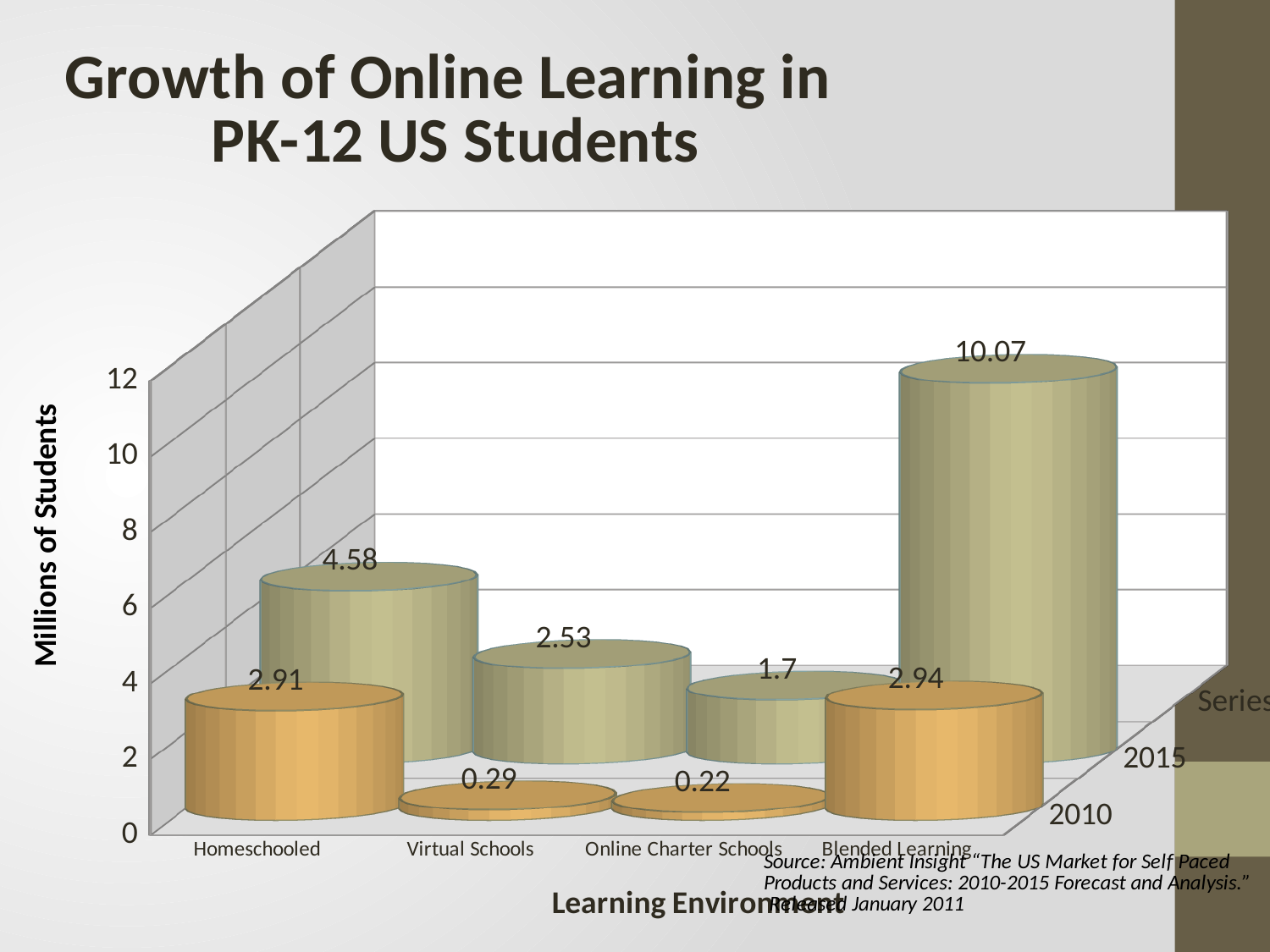
What is the value for Blended Learning in 2015? 10.07 What is the value for Homeschooled in 2010? 2.91 Which learning environment has the highest value in 2015? Blended Learning How many learning environment categories are shown on the x axis? 4 What is the value for Online Charter Schools in 2010? 0.22 What type of chart is shown on the slide? Bar chart What is the label of the vertical axis? Millions of Students Which is larger: the 2015 value for Homeschooled or the 2015 value for Virtual Schools? Homeschooled How many data series (years) are plotted in the chart? 2 What is the value for Virtual Schools in 2015? 2.53 Which learning environment has the lowest value in 2010? Online Charter Schools What is the difference between the 2015 and 2010 values for Blended Learning? 7.13